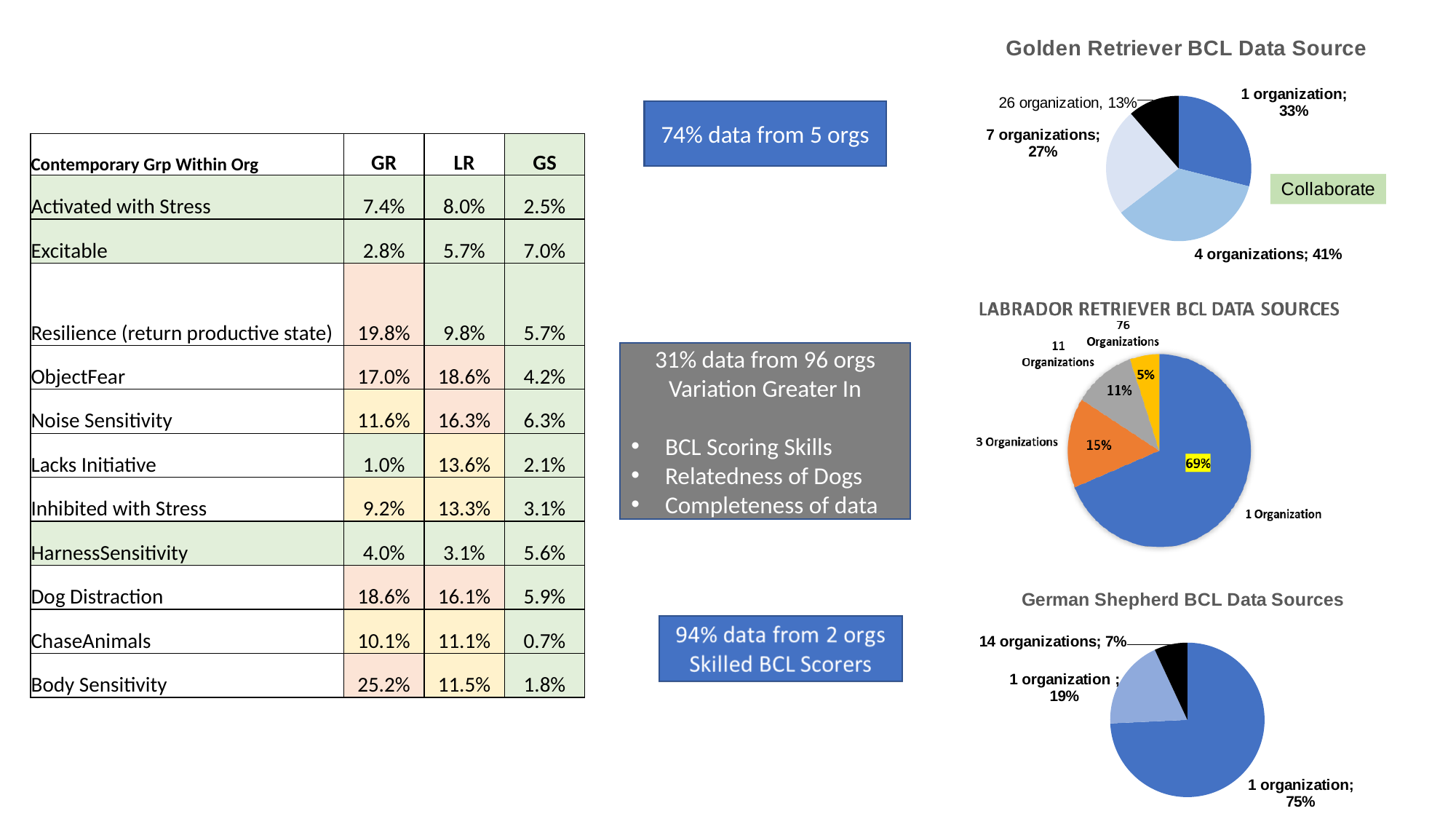
In the Labrador Retriever BCL Data Sources chart, what percentage is shown for 1 Organization? 69% In the German Shepherd BCL Data Sources chart, what is the difference between the largest slice (75%) and the 19% slice? 56% How many slices does the German Shepherd BCL Data Sources pie chart have? 3 In the German Shepherd BCL Data Sources chart, what share is shown for 14 organizations? 7% In the Golden Retriever BCL Data Source chart, which slice is the smallest? 26 organization In the Labrador Retriever BCL Data Sources chart, what is the difference between the 3 Organizations share and the 11 Organizations share? 4% What kind of chart is the Golden Retriever BCL Data Source chart? Pie chart In the Golden Retriever BCL Data Source chart, which slice is the largest? 4 organizations In the Labrador Retriever BCL Data Sources chart, which is larger: the 3 Organizations slice or the 11 Organizations slice? 3 Organizations How many slices does the Golden Retriever BCL Data Source pie chart have? 4 In the Labrador Retriever BCL Data Sources chart, what percentage is shown for 76 Organizations? 5% In the Golden Retriever BCL Data Source chart, what share of the data comes from the 4 organizations slice? 41%